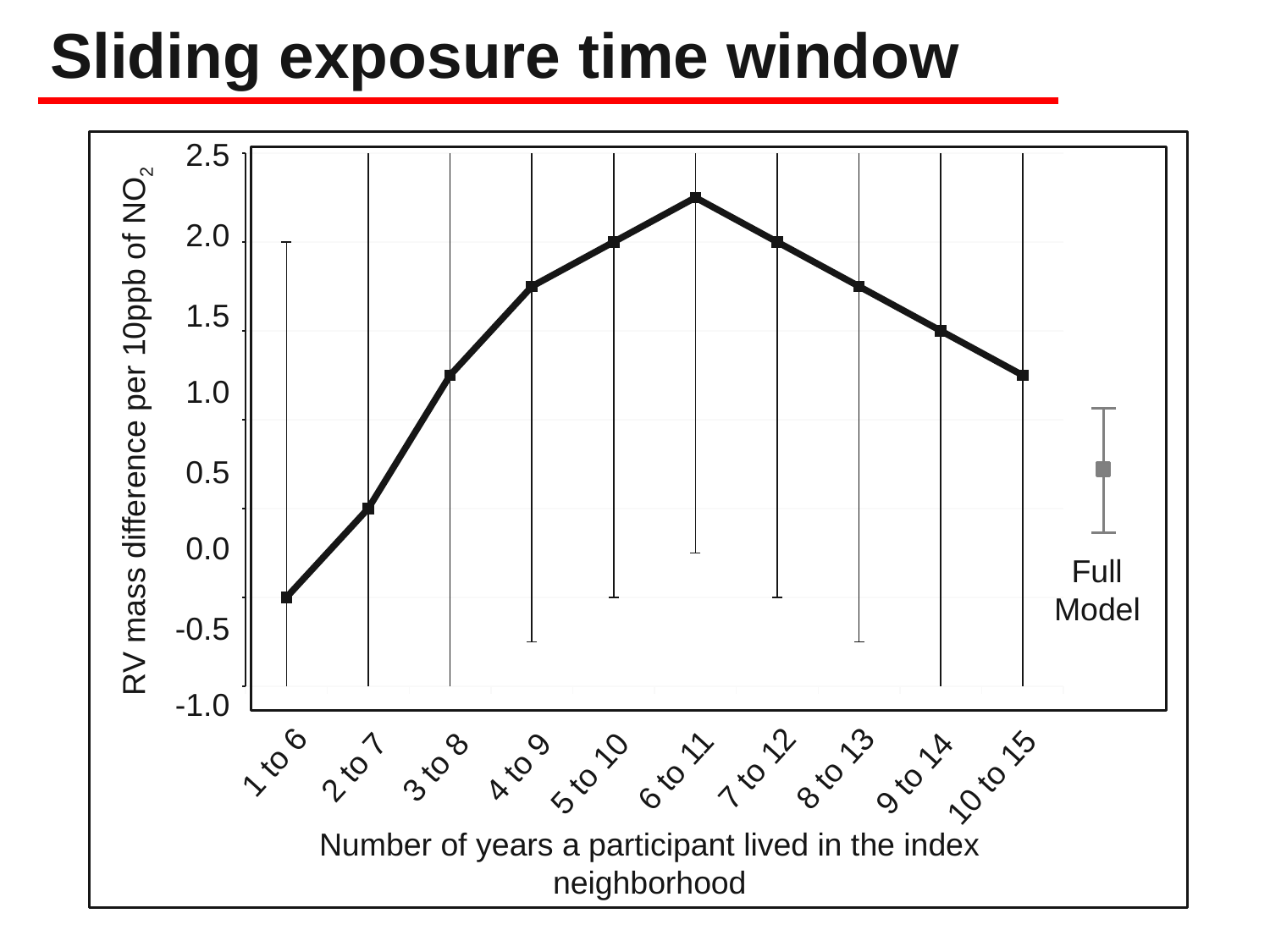
How many exposure time windows are plotted along the x axis? 10 Is the value for the 6 to 11 window greater or less than 2.0? greater Which has the larger RV mass difference, the 4 to 9 window or the 10 to 15 window? 4 to 9 Which has the larger RV mass difference, the 2 to 7 window or the 9 to 14 window? 9 to 14 Is the value for the 2 to 7 window greater or less than 0.5? less Is the value for the 3 to 8 window greater or less than 1.0? greater What kind of chart is shown on the slide? line chart What is the label of the y axis? RV mass difference per 10ppb of NO2 How do the values change along the x axis from 1 to 6 through 10 to 15? rise to a peak at 6 to 11, then fall Which exposure time window has the highest RV mass difference? 6 to 11 Which exposure time window has the lowest RV mass difference? 1 to 6